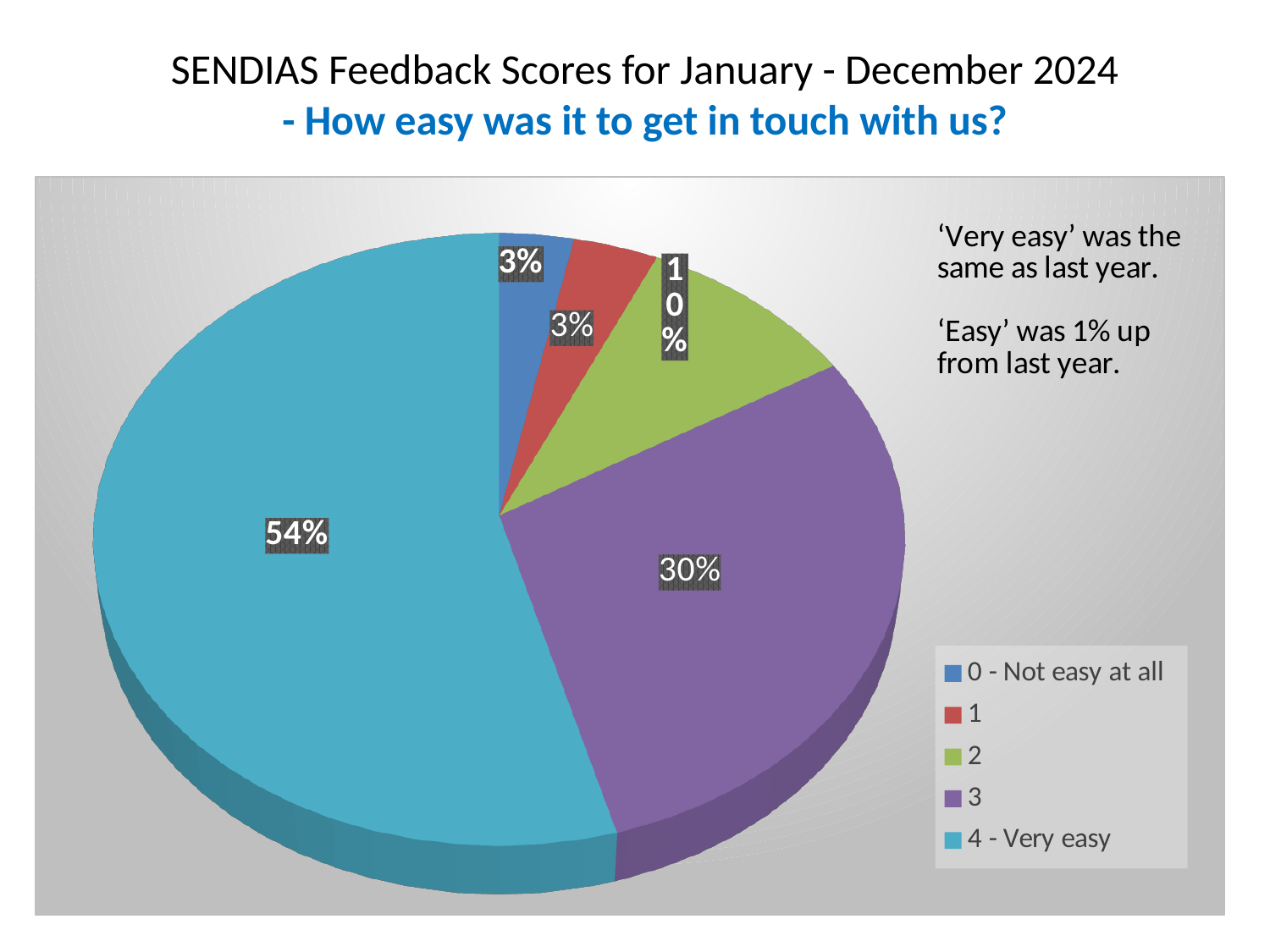
What kind of chart is shown on the slide? Pie chart How many categories does the legend list? 5 What colour is the '4 - Very easy' slice? Teal/light blue What is the difference between the '4 - Very easy' slice and the '3' slice? 24% What share of the pie is '4 - Very easy'? 54% What share of the pie is category '2'? 10% What share of the pie is '0 - Not easy at all'? 3% Which is larger, the slice for '2' or the slice for '1'? 2 What share of the pie is category '3'? 30% What is the combined share of the '3' and '4 - Very easy' slices? 84% What question does the chart's subtitle say the feedback scores relate to? How easy was it to get in touch with us? Which category has the largest slice of the pie? 4 - Very easy